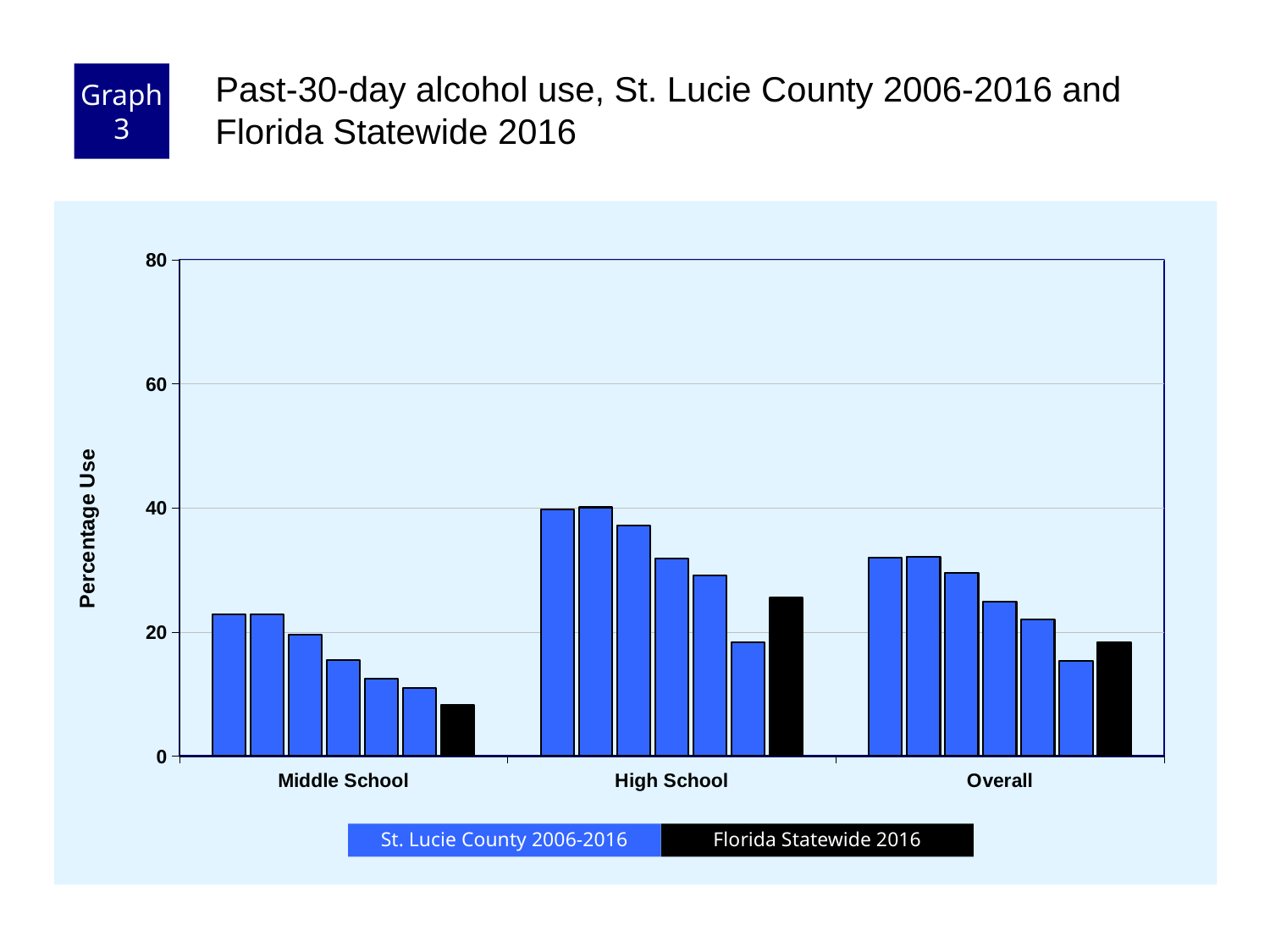
Which category has the highest bars overall? High School What is the label on the y axis? Percentage Use Is the Florida Statewide 2016 value for Middle School greater or less than 20? less Is the tallest St. Lucie County bar for Overall greater or less than 40? less How many series does the legend list? 2 How many categories are shown on the x axis? 3 Is the Florida Statewide 2016 value for High School greater or less than 20? greater Within each category, do the St. Lucie County 2006-2016 bars rise or fall from left to right? fall Which is larger: the Florida Statewide 2016 value for High School or for Middle School? High School Which category has the lowest bars overall? Middle School What kind of chart is shown on the slide? bar chart What colour represents Florida Statewide 2016 in the legend? black